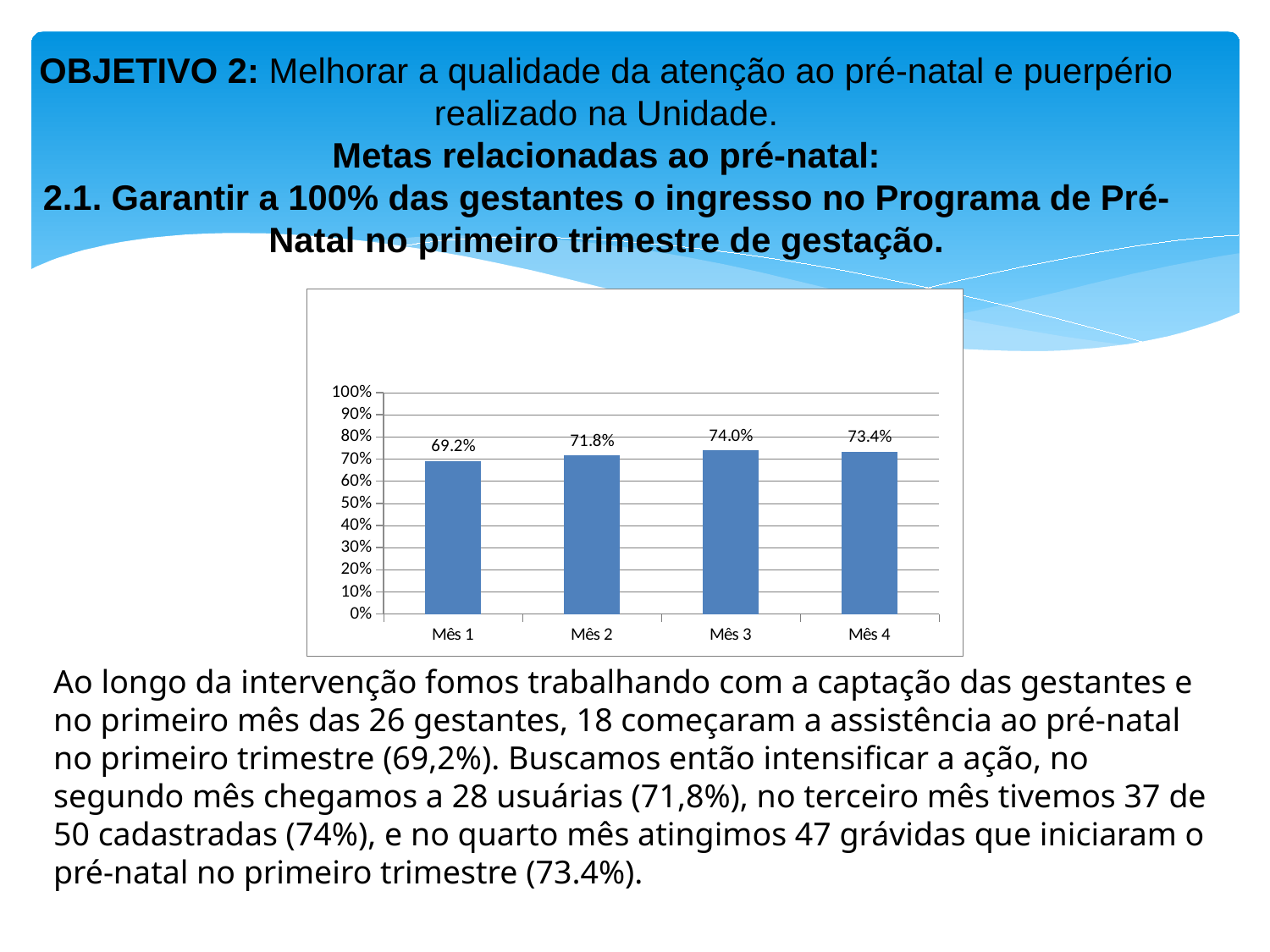
What kind of chart is shown on the slide? bar chart What is the value for Mês 3? 74.0% Do the values rise or fall from Mês 1 to Mês 3? rise How many months are shown on the x axis? 4 Which month has the highest value? Mês 3 Which month has the lowest value? Mês 1 What is the value for Mês 2? 71.8% What is the difference between the values for Mês 3 and Mês 1? 4.8 percentage points What is the value for Mês 4? 73.4% Which is larger, the value for Mês 3 or the value for Mês 4? Mês 3 Is the value for Mês 3 greater or less than 80%? less What is the value for Mês 1? 69.2%